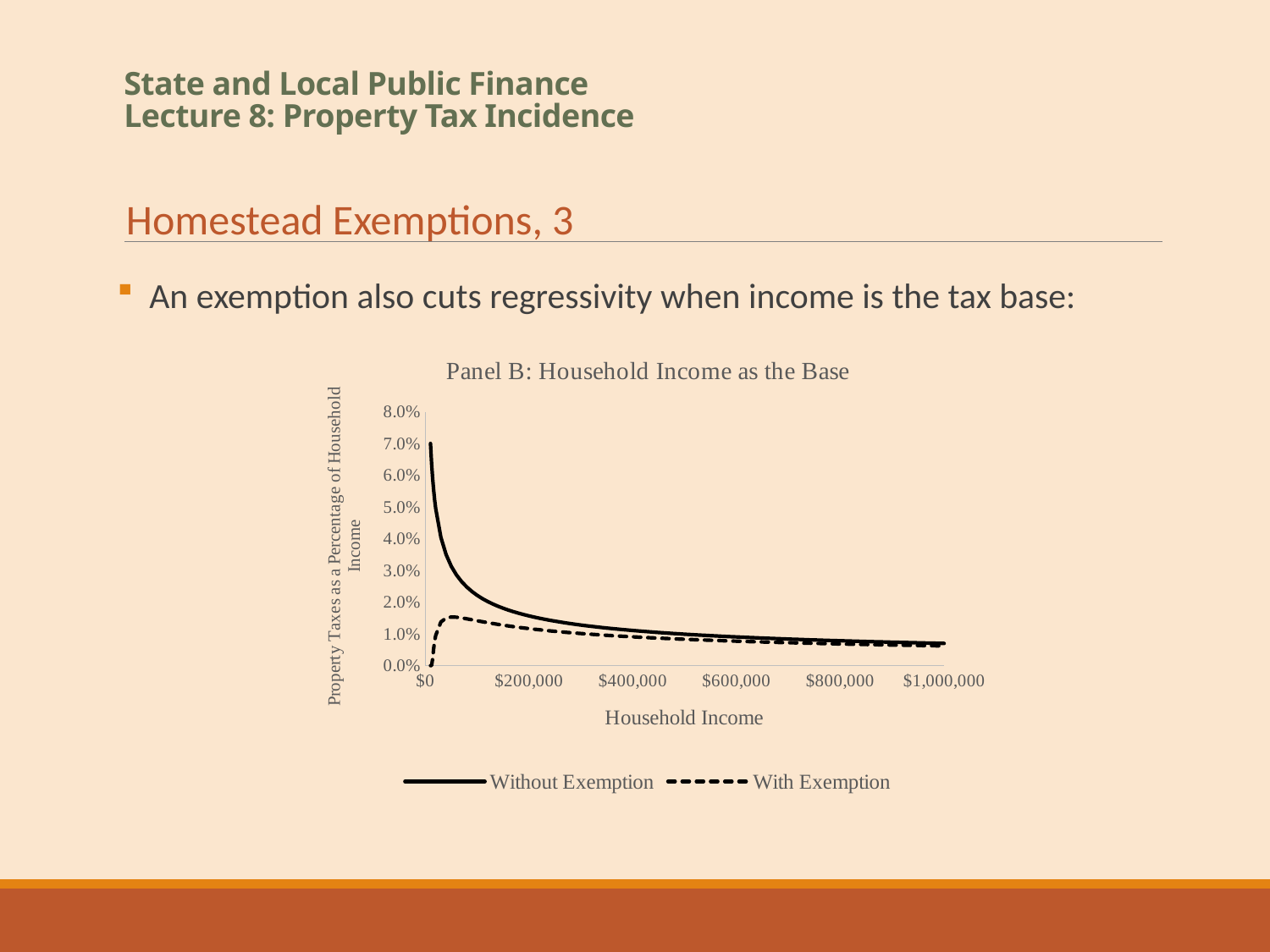
Does the Without Exemption line rise or fall as household income increases? fall At a household income of $200,000, which series has the higher value, Without Exemption or With Exemption? Without Exemption Which series has the lower value at $600,000 of household income? With Exemption How many series does the chart's legend list? 2 What is the highest value labelled on the chart's vertical axis? 8.0% Is the value of the With Exemption line at $800,000 of household income greater or less than 1.0%? less What are the two series named in the chart's legend? Without Exemption and With Exemption What is the title of the chart? Panel B: Household Income as the Base Is the highest value reached by the With Exemption line greater or less than 2.0%? less Is the value of the Without Exemption line at $400,000 of household income greater or less than 2.0%? less What kind of chart is shown on the slide? line chart